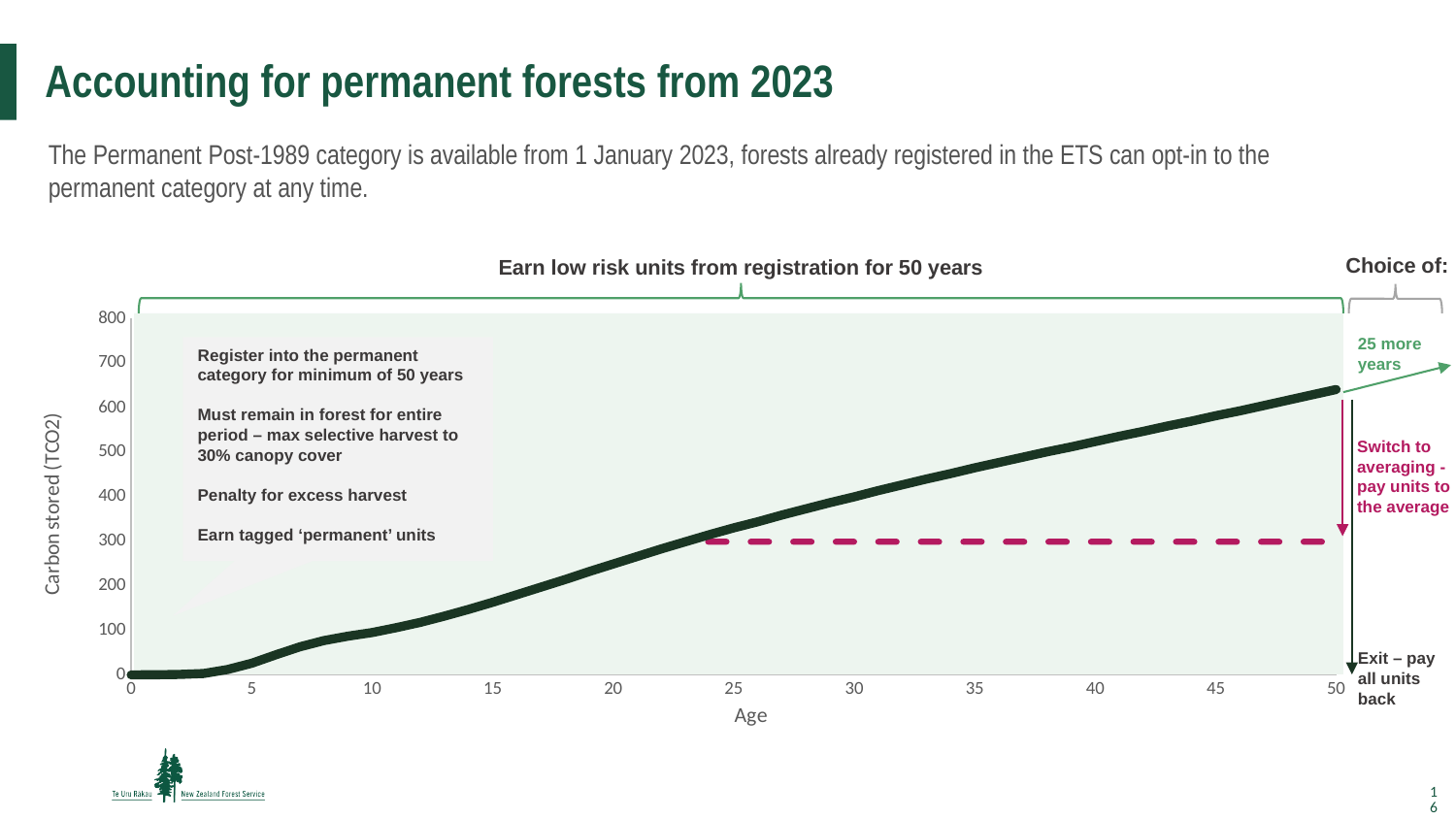
What is the label of the x axis of the chart? Age What is the label of the y axis of the chart? Carbon stored (TCO2) What is the carbon stored value at age 0? 0 Is the carbon stored value at age 15 greater or less than 300? less Is the carbon stored value at age 25 greater or less than 200? greater What kind of chart is shown on the slide? line chart Does the solid line of carbon stored rise or fall as age increases from 0 to 50? rise Is the carbon stored value at age 40 greater or less than 400? greater Which age has the higher carbon stored value, age 20 or age 45? age 45 What is the highest value shown on the y axis of the chart? 800